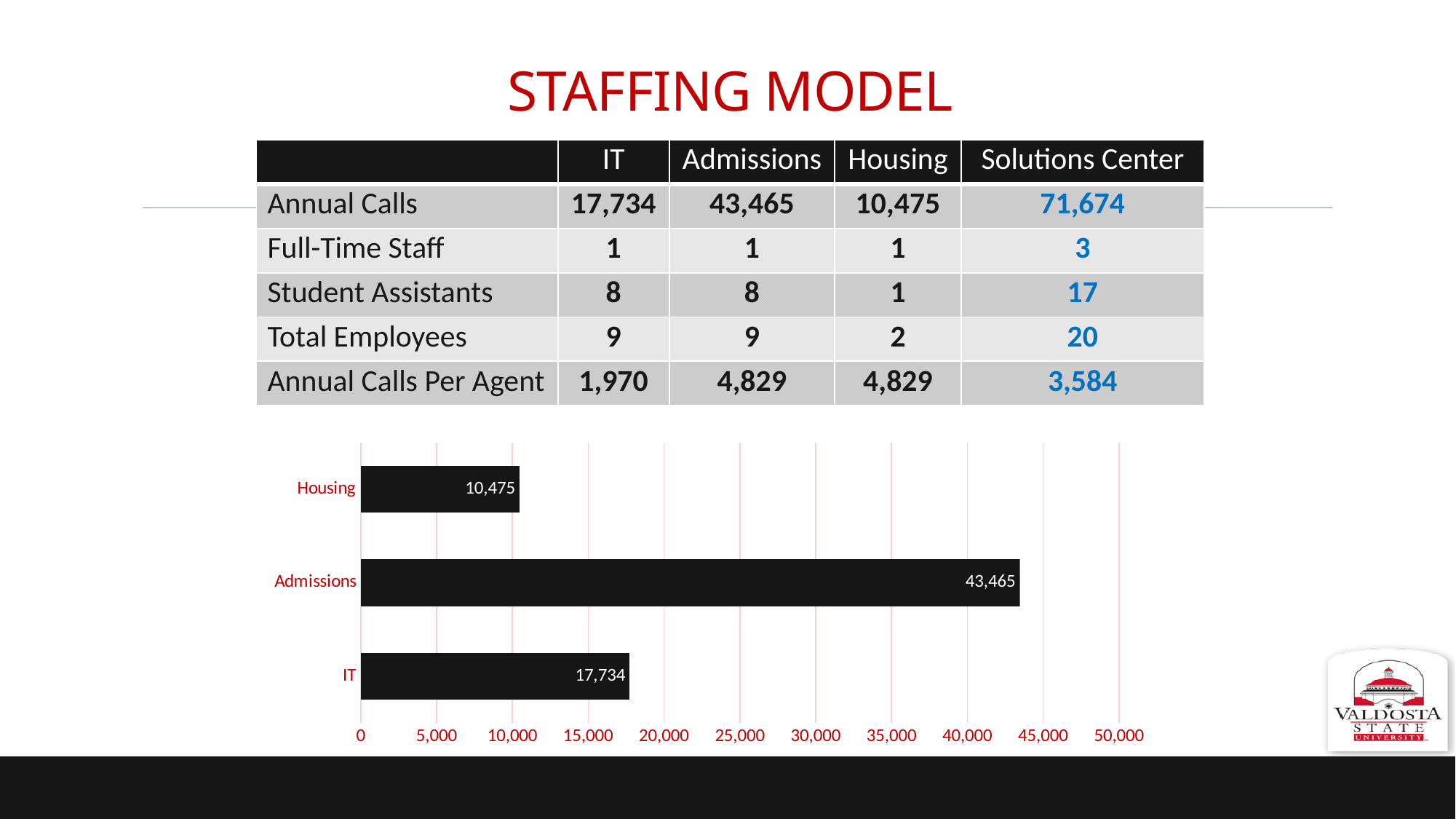
Which is larger in the bar chart, IT or Housing? IT Which category has the lowest value in the bar chart? Housing What is the value of the bar for Housing? 10,475 What is the difference between the IT bar and the Housing bar? 7,259 What is the value of the bar for Admissions? 43,465 How many categories are shown in the bar chart? 3 What is the value of the bar for IT? 17,734 What is the maximum value shown on the chart's horizontal axis? 50,000 Which category has the highest value in the bar chart? Admissions Is the value for Admissions greater or less than 40,000? greater What is the difference between the Admissions bar and the IT bar? 25,731 What kind of chart is shown on the slide? bar chart